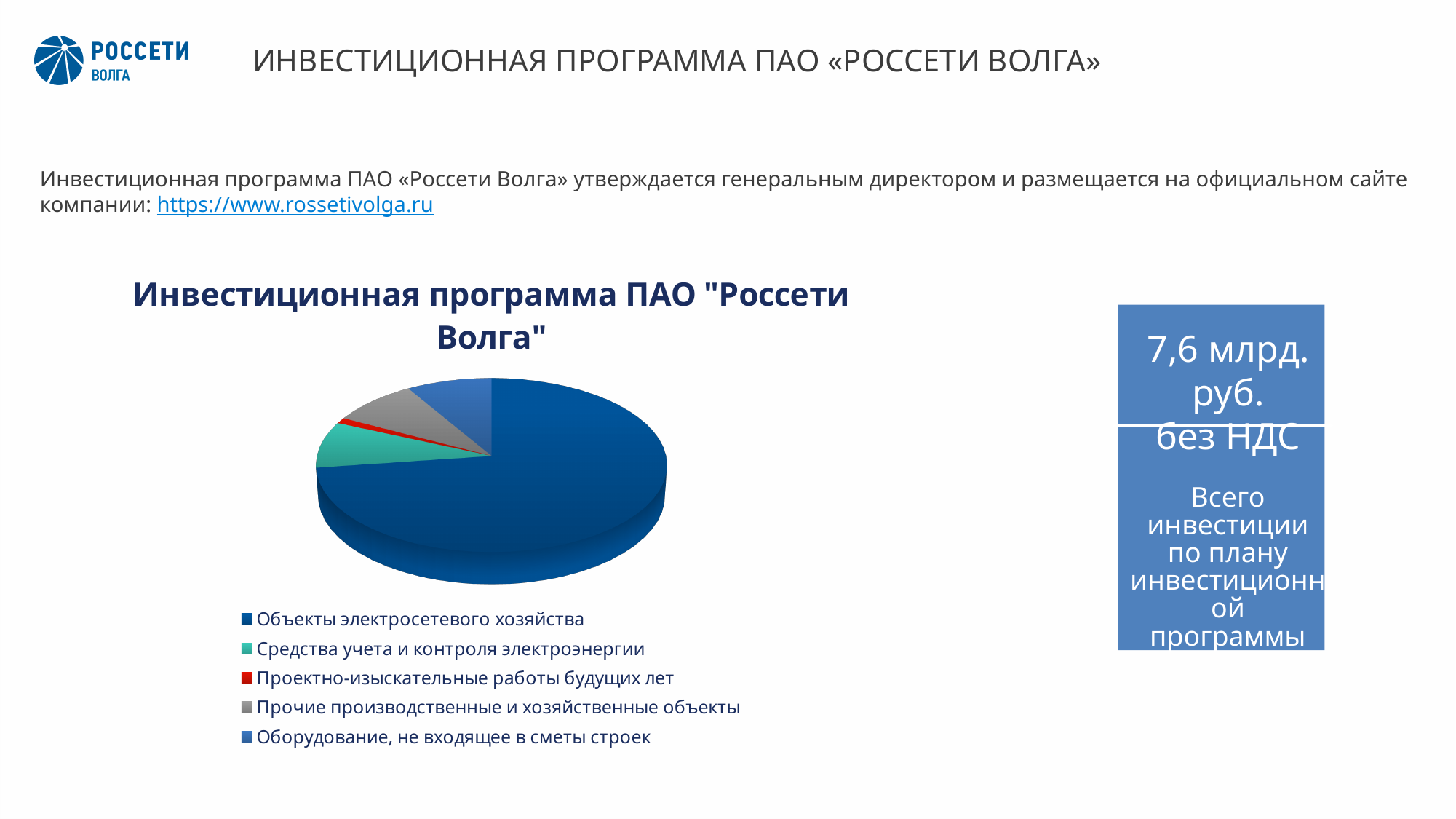
Does the largest slice of the pie chart take up more or less than half of the pie? more Which category has the largest slice of the pie chart? Объекты электросетевого хозяйства Which category has the smallest slice of the pie chart? Проектно-изыскательные работы будущих лет Which colour represents "Проектно-изыскательные работы будущих лет" in the legend? red Which slice is larger: "Объекты электросетевого хозяйства" or "Оборудование, не входящее в сметы строек"? Объекты электросетевого хозяйства Which slice is larger: "Средства учета и контроля электроэнергии" or "Проектно-изыскательные работы будущих лет"? Средства учета и контроля электроэнергии What kind of chart is shown on the slide? pie chart How many categories does the pie chart show? 5 What is the title of the pie chart? Инвестиционная программа ПАО "Россети Волга" Which slice is larger: "Прочие производственные и хозяйственные объекты" or "Проектно-изыскательные работы будущих лет"? Прочие производственные и хозяйственные объекты